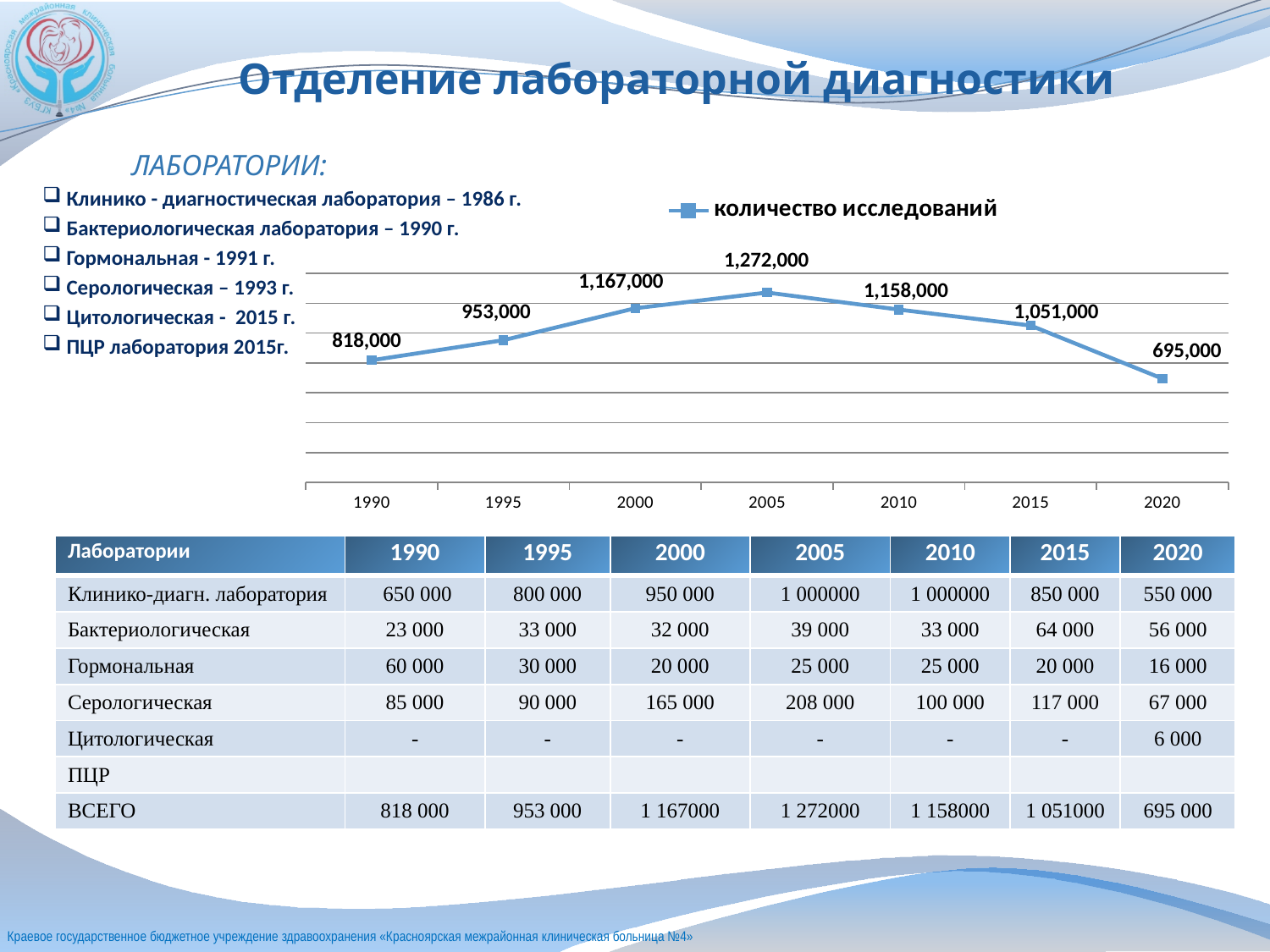
What is the value for 1990 on the chart? 818,000 How many data points are plotted on the chart? 7 What is the difference between the values for 2005 and 2020? 577,000 What is the value for 2005 on the chart? 1,272,000 What kind of chart is shown on the slide? line chart Which year has the highest value on the chart? 2005 Which year has the lowest value on the chart? 2020 What is the value for 2020 on the chart? 695,000 What is the difference between the values for 1995 and 1990? 135,000 What is the value for 2015 on the chart? 1,051,000 What series name does the chart legend show? количество исследований Which is larger, the value for 2000 or the value for 2010? 2000